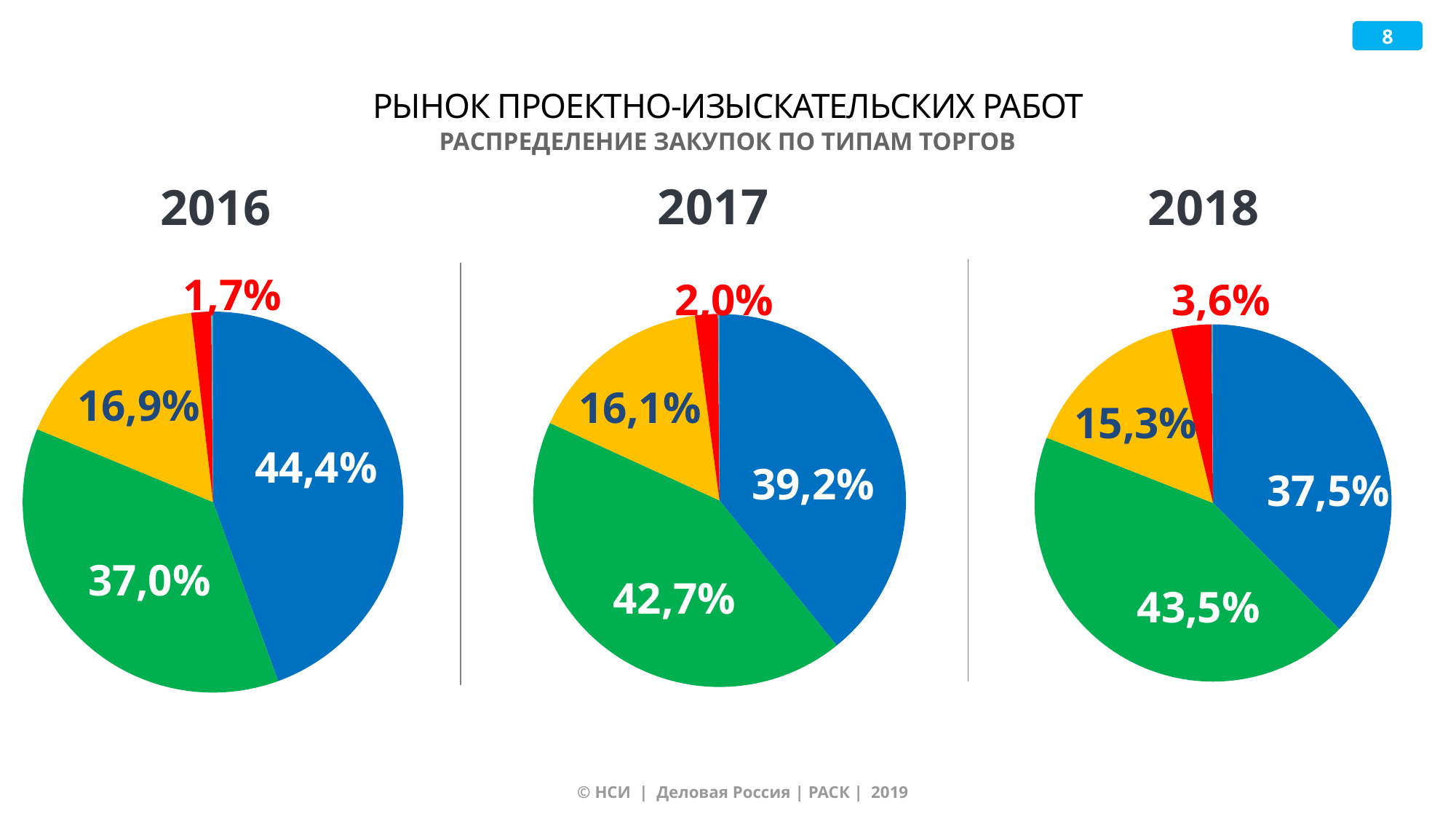
In the 2016 pie chart, which colour slice is the largest? blue How many pie charts are shown on the slide? 3 What kind of chart is used for the 2016 data on the slide? pie chart In the 2018 pie chart, what share does the yellow slice have? 15,3% In the 2017 pie chart, which is larger, the blue slice or the green slice? green How many slices does the 2017 pie chart have? 4 In the 2018 pie chart, what share does the red slice have? 3,6% In the 2016 pie chart, what share does the blue slice have? 44,4% In the 2016 pie chart, what is the difference between the blue slice and the green slice? 7,4% In the 2017 pie chart, what share does the green slice have? 42,7% Across the three pie charts, does the share of the red slice rise or fall from 2016 to 2018? rise In the 2018 pie chart, which colour slice is the smallest? red